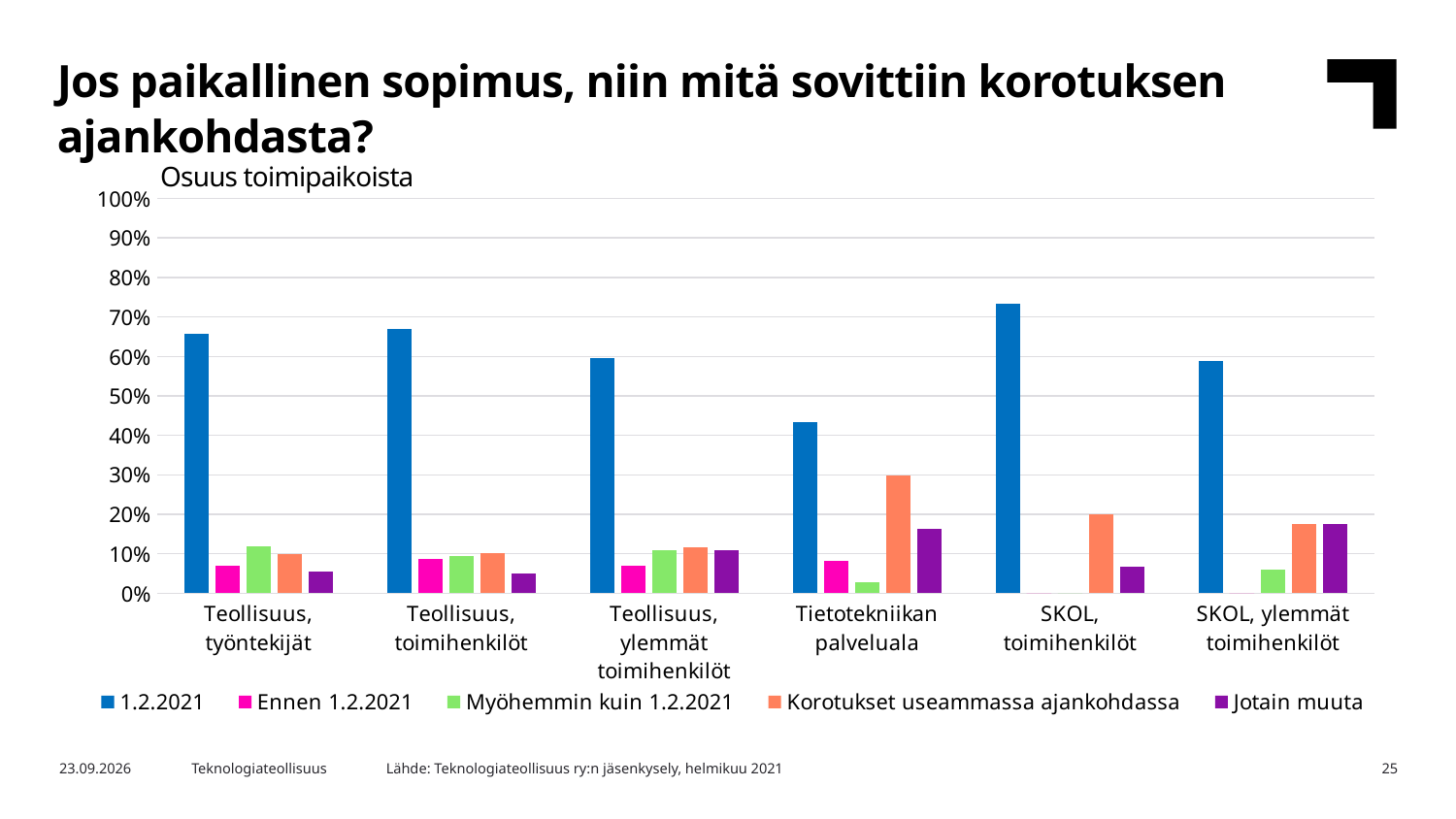
Which category has the highest value for the series Korotukset useammassa ajankohdassa? Tietotekniikan palveluala Is the value for Korotukset useammassa ajankohdassa in Tietotekniikan palveluala greater or less than 20%? greater What kind of chart is shown on the slide? bar chart Is the value for 1.2.2021 in SKOL, toimihenkilöt greater or less than 70%? greater Is the value for 1.2.2021 in Tietotekniikan palveluala greater or less than 50%? less Which category has the lowest value for the series 1.2.2021? Tietotekniikan palveluala How many categories are shown along the x axis? 6 How many series does the legend list? 5 In Tietotekniikan palveluala, which is larger: Korotukset useammassa ajankohdassa or Jotain muuta? Korotukset useammassa ajankohdassa Which category has the highest value for the series 1.2.2021? SKOL, toimihenkilöt What label is shown above the vertical axis of the chart? Osuus toimipaikoista Which is larger: the 1.2.2021 value for Teollisuus, työntekijät or for Teollisuus, ylemmät toimihenkilöt? Teollisuus, työntekijät